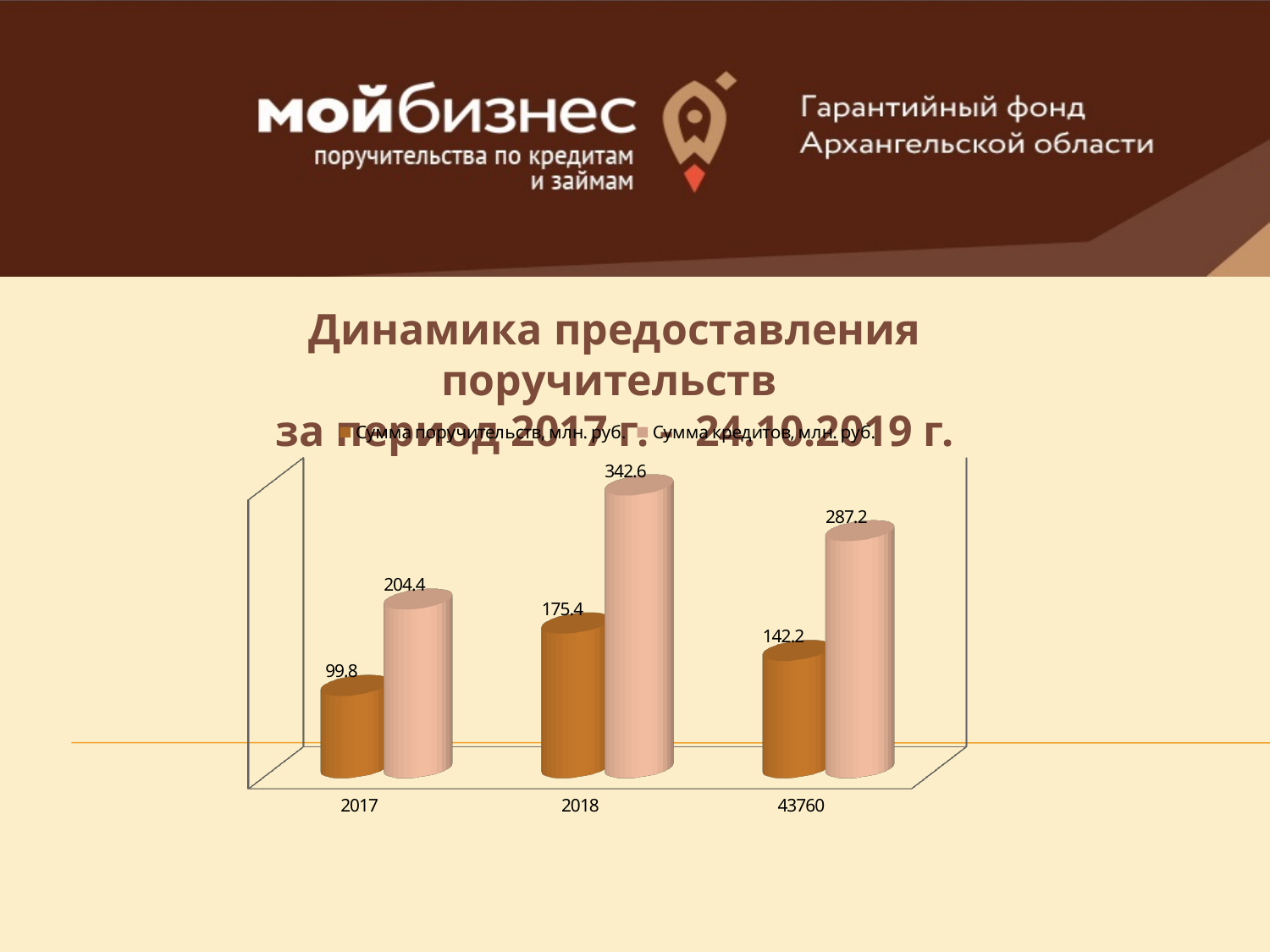
Which is larger: Сумма поручительств, млн. руб. for 2018 or for the category labelled 43760? 2018 What is the difference between Сумма кредитов, млн. руб. and Сумма поручительств, млн. руб. for 2018? 167.2 What is the value of Сумма кредитов, млн. руб. for 2018? 342.6 What kind of chart is shown on the slide? bar chart Which category has the highest value for Сумма кредитов, млн. руб.? 2018 What is the label of the third category on the x axis? 43760 What is the value of Сумма кредитов, млн. руб. for 2017? 204.4 What is the value of Сумма поручительств, млн. руб. for 2017? 99.8 What is the value of Сумма поручительств, млн. руб. for the category labelled 43760? 142.2 How many categories are shown on the x axis? 3 Which category has the lowest value for Сумма поручительств, млн. руб.? 2017 How many series does the legend list? 2